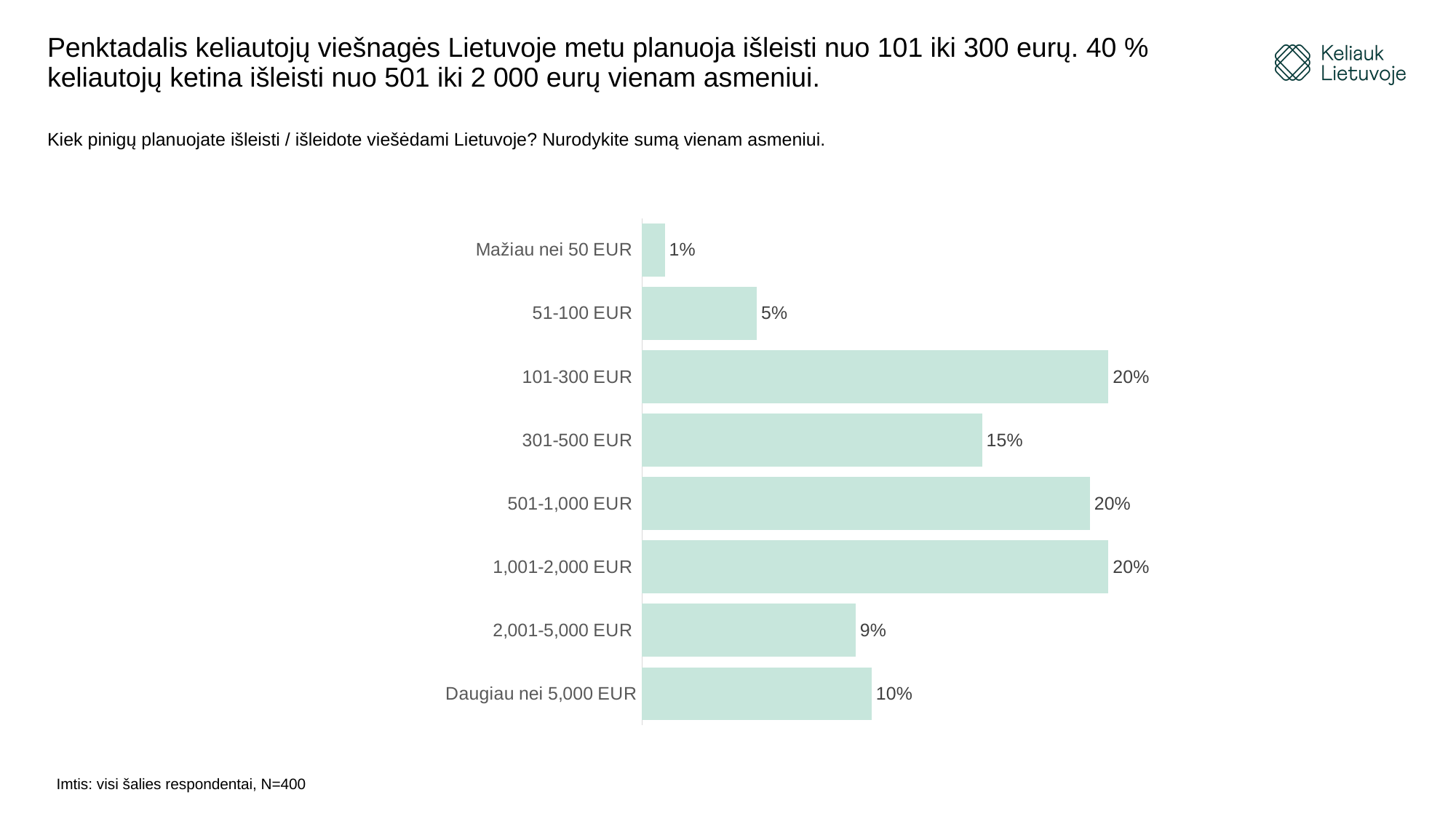
How many categories share the highest value of 20%? 3 What is the difference between the values for 301-500 EUR and 51-100 EUR? 10% What is the difference between the values for 'Daugiau nei 5,000 EUR' and 2,001-5,000 EUR? 1% Which is larger: the value for 51-100 EUR or the value for 'Mažiau nei 50 EUR'? 51-100 EUR How many categories are shown in the chart? 8 What type of chart is shown on the slide? Bar chart Which is larger: the value for 301-500 EUR or the value for 2,001-5,000 EUR? 301-500 EUR What is the value for the 2,001-5,000 EUR category? 9% What percentage of respondents plan to spend 101-300 EUR? 20% What is the value shown for the 301-500 EUR category? 15% What percentage is shown for 'Daugiau nei 5,000 EUR'? 10% Which category has the lowest value? Mažiau nei 50 EUR